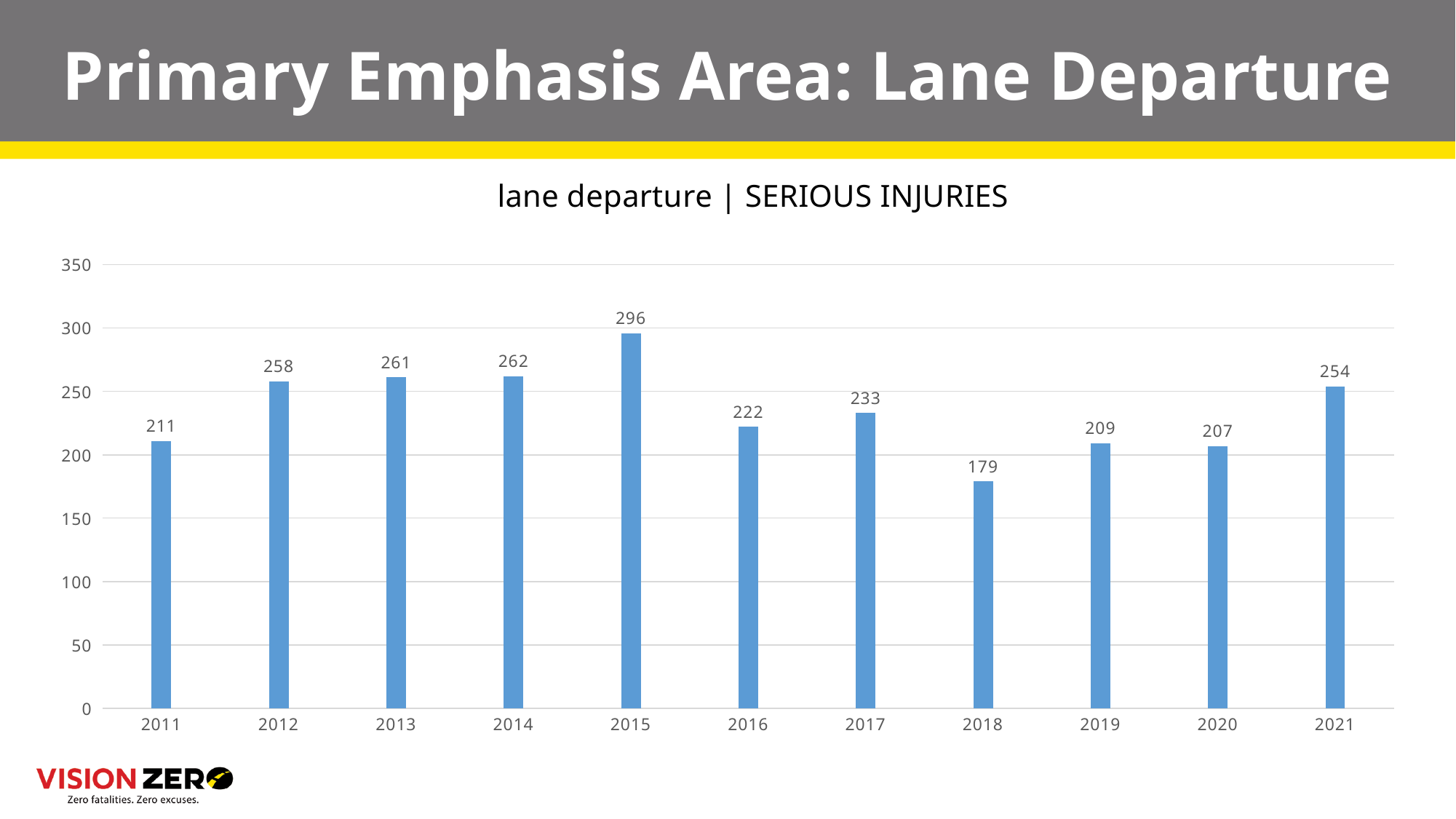
What is the title of the chart? lane departure | SERIOUS INJURIES Which year has the highest value? 2015 Which is larger, the value for 2017 or the value for 2016? 2017 What is the value for 2015? 296 What kind of chart is shown on the slide? bar chart Is the value for 2019 greater or less than 250? less What is the difference between the values for 2015 and 2018? 117 What is the value for 2021? 254 Which year has the lowest value? 2018 What is the difference between the values for 2012 and 2011? 47 What is the value for 2018? 179 How many years are shown on the x axis? 11